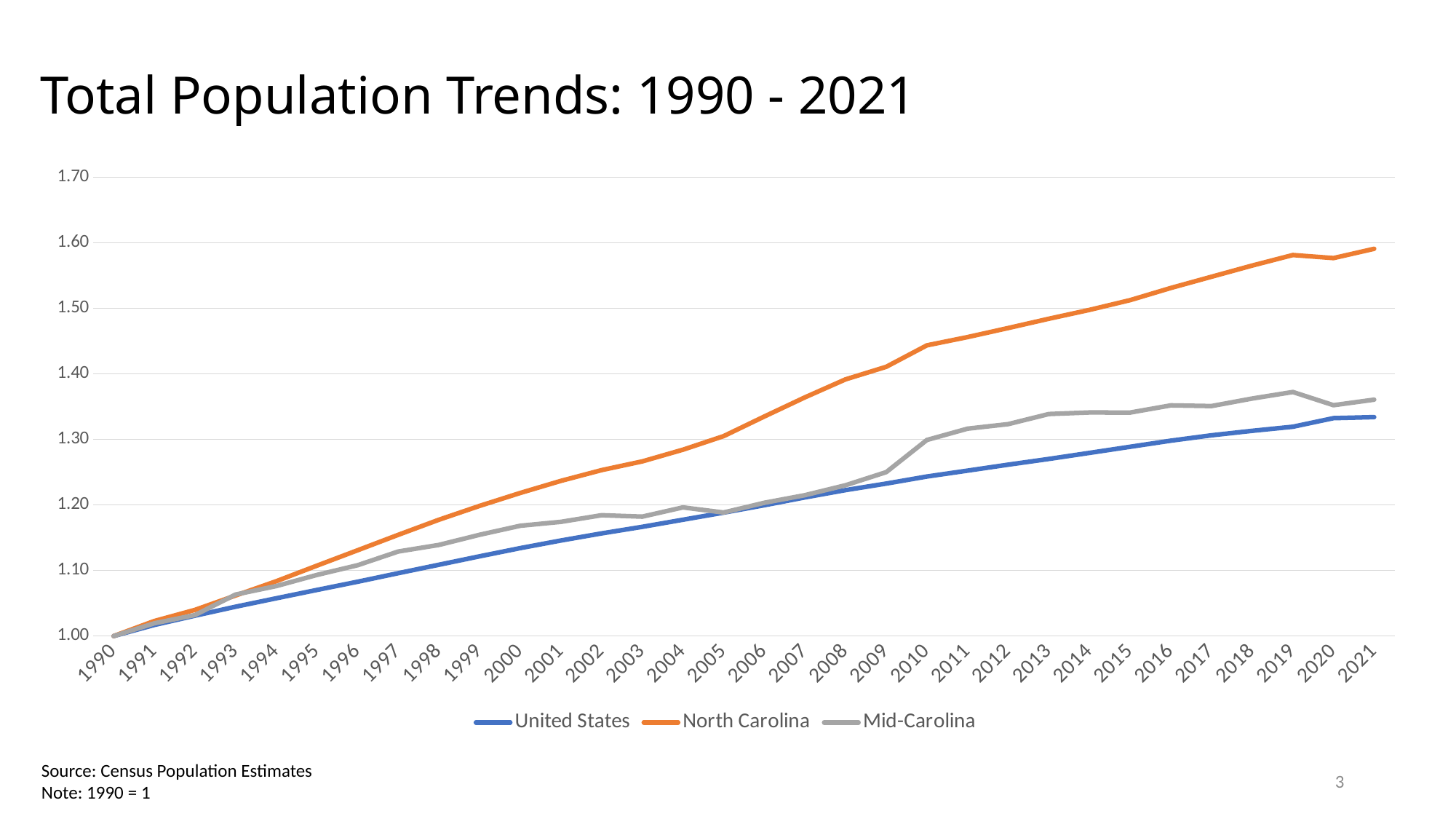
Do the values for North Carolina generally rise or fall from 1990 to 2021? rise How many years are plotted along the x axis? 32 Which series has the lowest value in 2021? United States Is the value for United States in 2010 greater or less than 1.30? less Which series has the highest value in 2021? North Carolina What is the value for all three series in 1990? 1.00 How many series does the legend list? 3 What colour is the North Carolina line? orange What kind of chart is shown on the slide? line chart Which is higher in 2015, North Carolina or Mid-Carolina? North Carolina Is the value for Mid-Carolina in 2021 greater or less than 1.40? less Is the value for North Carolina in 2021 greater or less than 1.50? greater